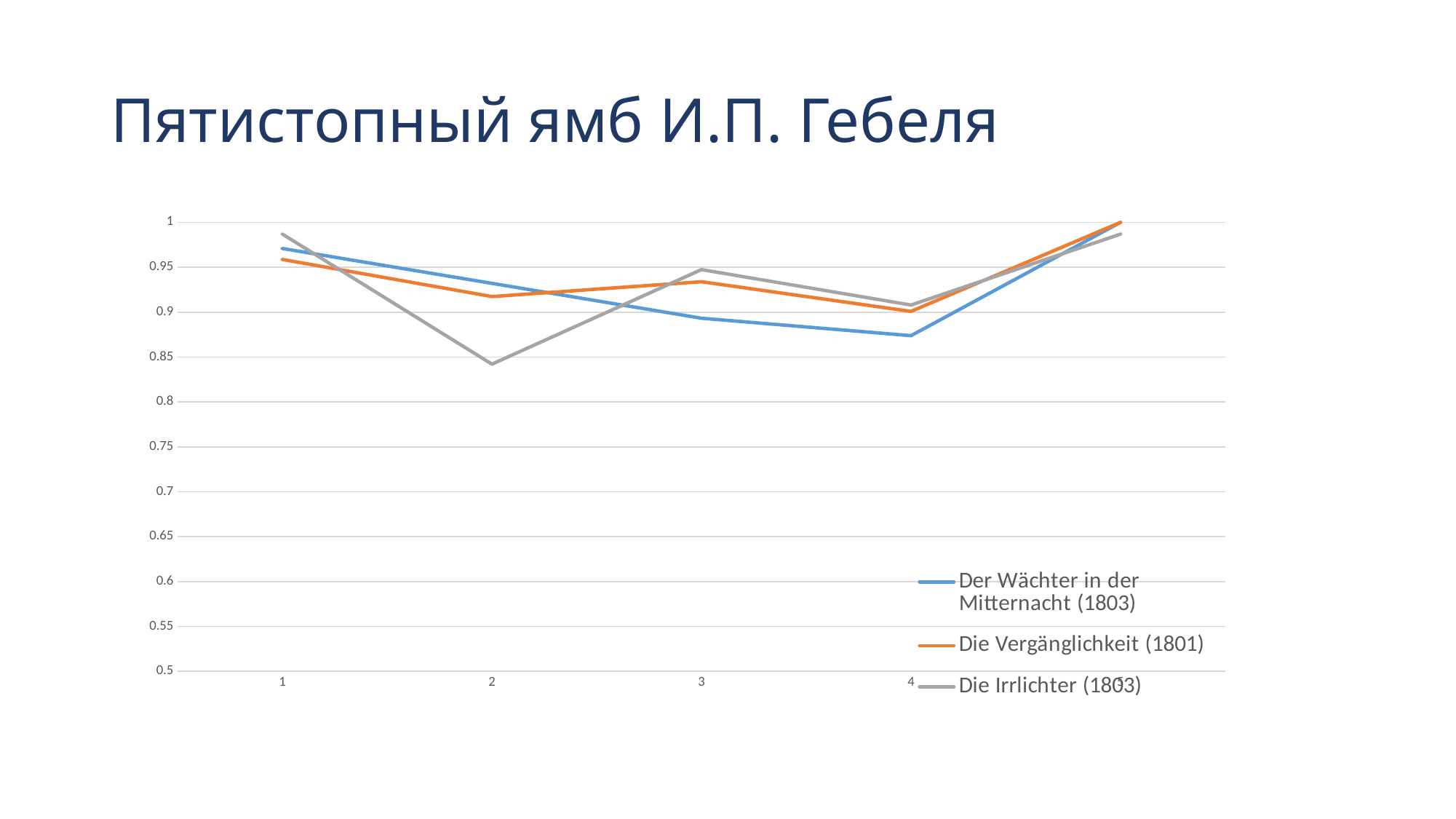
What kind of chart is shown on the slide? line chart Is the value for Die Irrlichter (1803) at position 1 greater or less than 0.95? greater How many series does the legend list? 3 Is the value for Die Vergänglichkeit (1801) at position 2 greater or less than 0.9? greater What is the title of the slide above the chart? Пятистопный ямб И.П. Гебеля At position 3, which series is higher: Die Irrlichter (1803) or Der Wächter in der Mitternacht (1803)? Die Irrlichter (1803) At which position does the Der Wächter in der Mitternacht (1803) series reach its lowest value? 4 Which colour is used for the series Die Irrlichter (1803)? gray Is the value for Der Wächter in der Mitternacht (1803) at position 4 greater or less than 0.9? less Does the Der Wächter in der Mitternacht (1803) line rise or fall from position 1 to position 4? fall Which series has the lowest value at position 2? Die Irrlichter (1803)